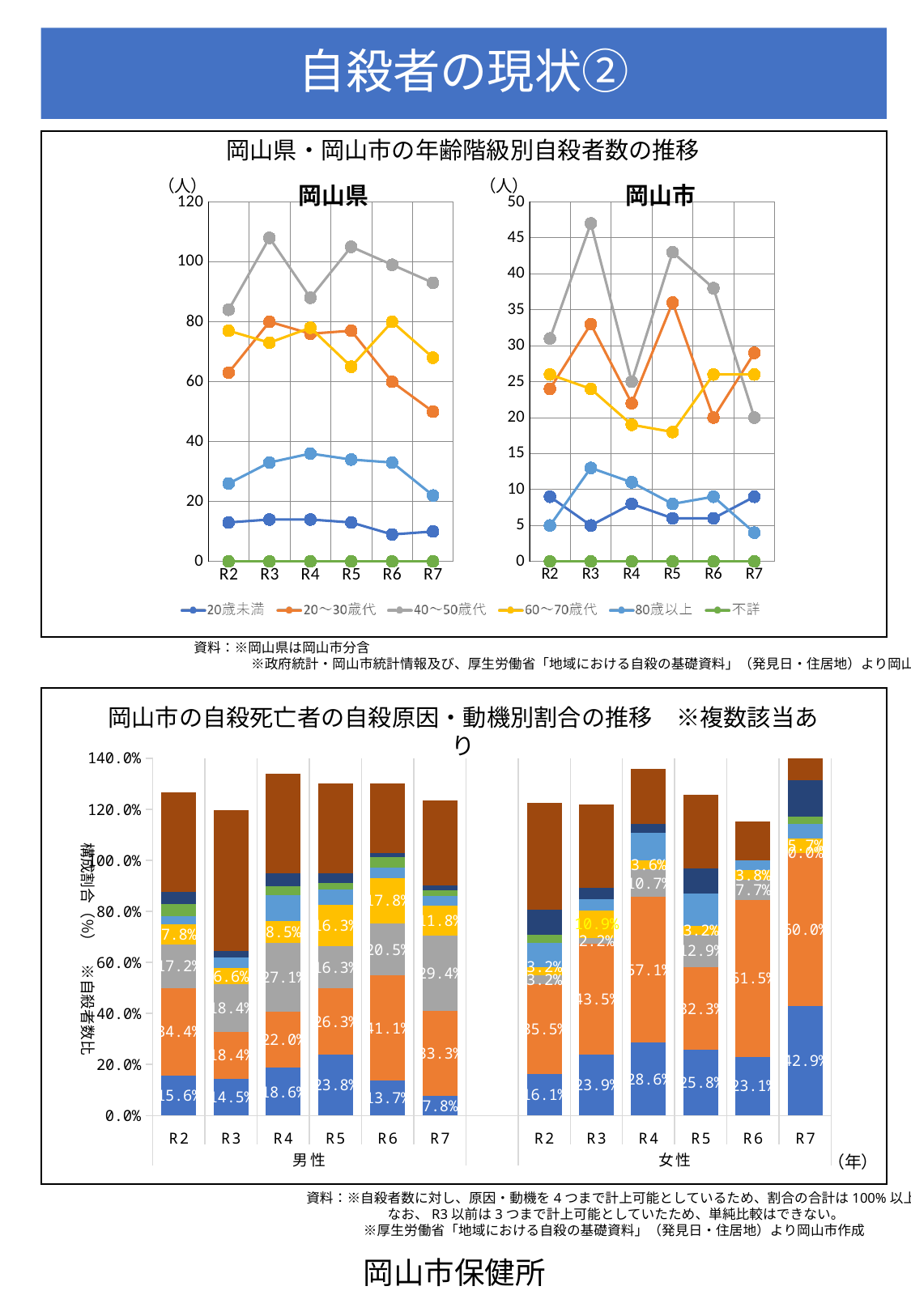
In the 岡山市の自殺死亡者の自殺原因・動機別割合の推移 chart, what is the value of the bottom (blue) segment for 男性 R2? 15.6% How many series does the legend list for the 岡山県・岡山市 age-group line charts? 6 In the 岡山市 chart, which series has the lowest value in R7? 不詳 In the 岡山県 chart, does the 20〜30歳代 series rise or fall from R5 to R7? fall How many years are plotted along the x axis of the 岡山県 chart? 6 In the 岡山県 chart, is the value for 40〜50歳代 in R3 greater or less than 100? greater In the 岡山市の自殺死亡者の自殺原因・動機別割合の推移 chart, what is the difference between the bottom (blue) segment for 女性 R7 (42.9%) and for 男性 R7 (7.8%)? 35.1% What kind of chart is the 岡山県 chart on the slide? line chart In the 岡山県 chart, which is larger in R7: 20〜30歳代 or 60〜70歳代? 60〜70歳代 What kind of chart is the 岡山市の自殺死亡者の自殺原因・動機別割合の推移 chart? stacked bar chart In the 岡山市 chart, is the value for 40〜50歳代 in R3 greater or less than 45? greater In the 岡山県 chart, which age group has the highest value in R3? 40〜50歳代